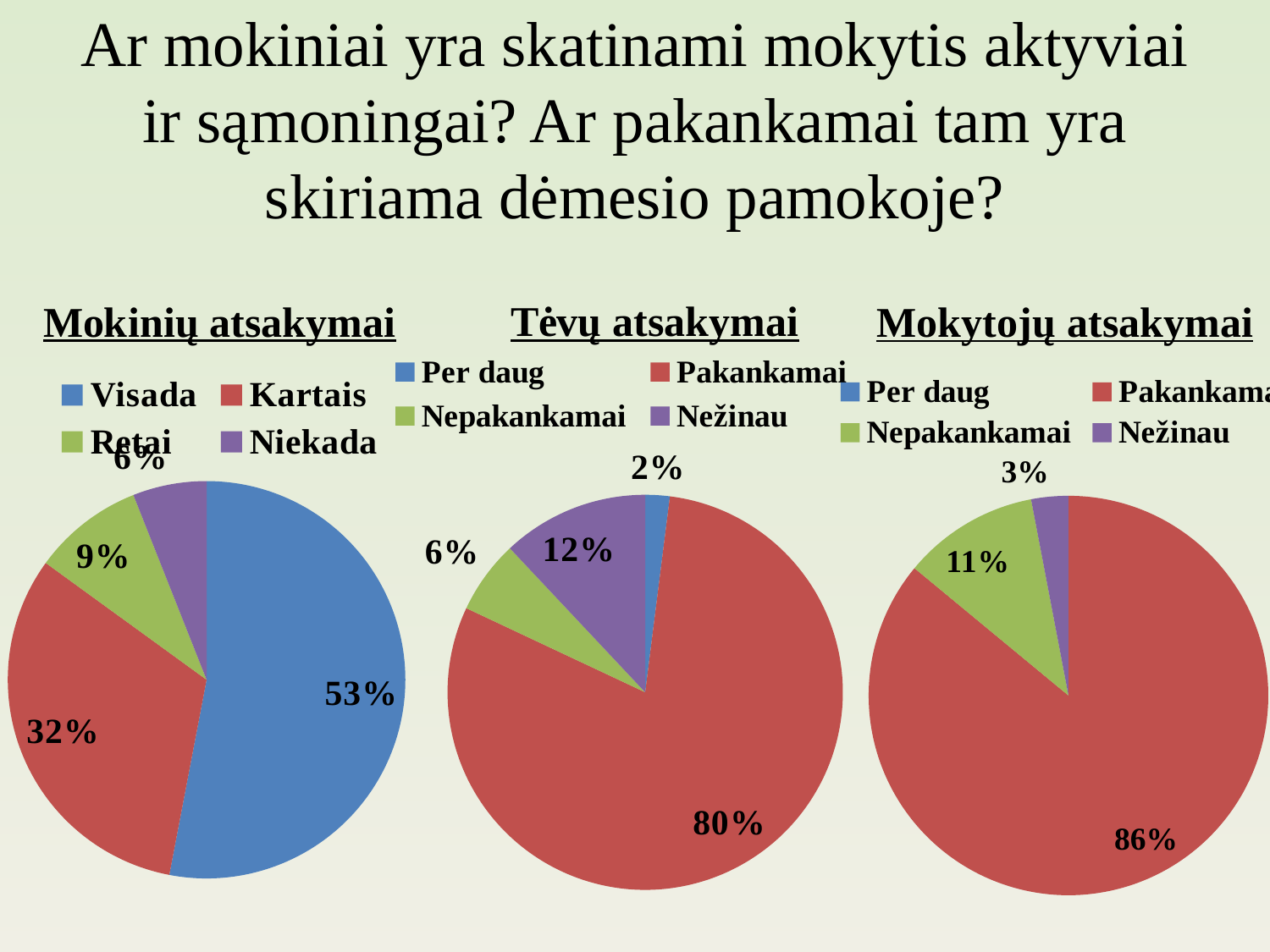
In the Tėvų atsakymai chart, what percentage is shown for Nežinau? 12% In the Mokytojų atsakymai chart, what percentage is shown for Nepakankamai? 11% What type of chart is the Tėvų atsakymai chart? Pie chart In the Mokinių atsakymai chart, how many categories does the legend list? 4 In the Mokinių atsakymai chart, what percentage is shown for Visada? 53% In the Mokinių atsakymai chart, which category has the smallest slice? Niekada In the Tėvų atsakymai chart, which category has the smallest slice? Per daug In the Mokinių atsakymai chart, what is the difference between the Visada and Kartais percentages? 21% In the Mokytojų atsakymai chart, what percentage is shown for Nežinau? 3% In the Tėvų atsakymai chart, which is larger, Nežinau or Nepakankamai? Nežinau In the Tėvų atsakymai chart, what percentage is shown for Per daug? 2% In the Mokinių atsakymai chart, which category has the largest slice? Visada